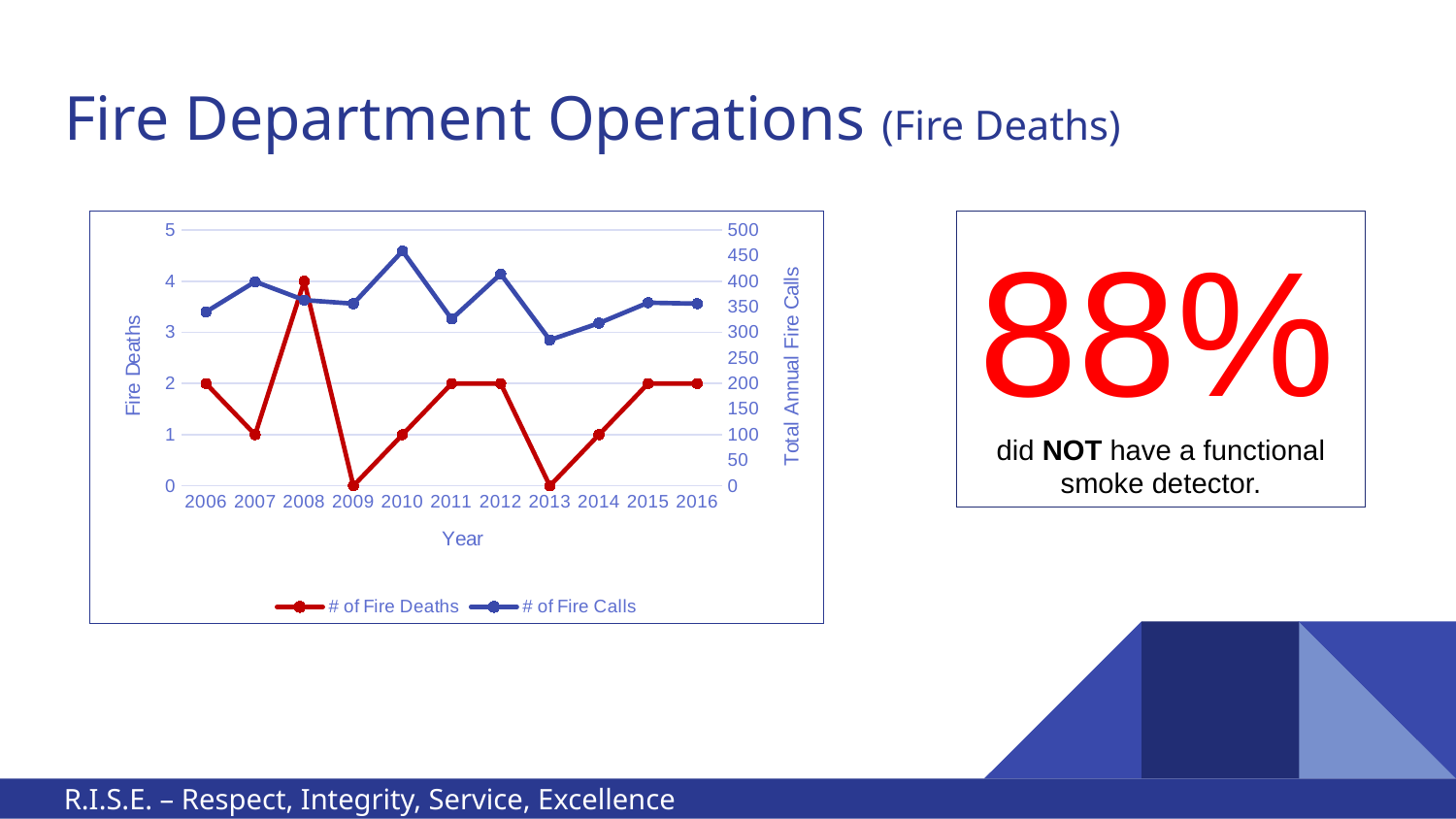
Which year has the highest number of fire calls? 2010 What is the number of fire deaths in 2008? 4 Which year had more fire deaths, 2006 or 2007? 2006 Is the number of fire calls in 2013 greater or less than 300? less What kind of chart is shown on the slide? line chart Which year has the highest number of fire deaths? 2008 What is the difference between the number of fire deaths in 2008 and in 2007? 3 What is the number of fire deaths in 2009? 0 How many years are plotted along the x axis of the chart? 11 How many series does the chart's legend list? 2 What is the title of the right-hand vertical axis of the chart? Total Annual Fire Calls Is the number of fire calls in 2010 greater or less than 400? greater